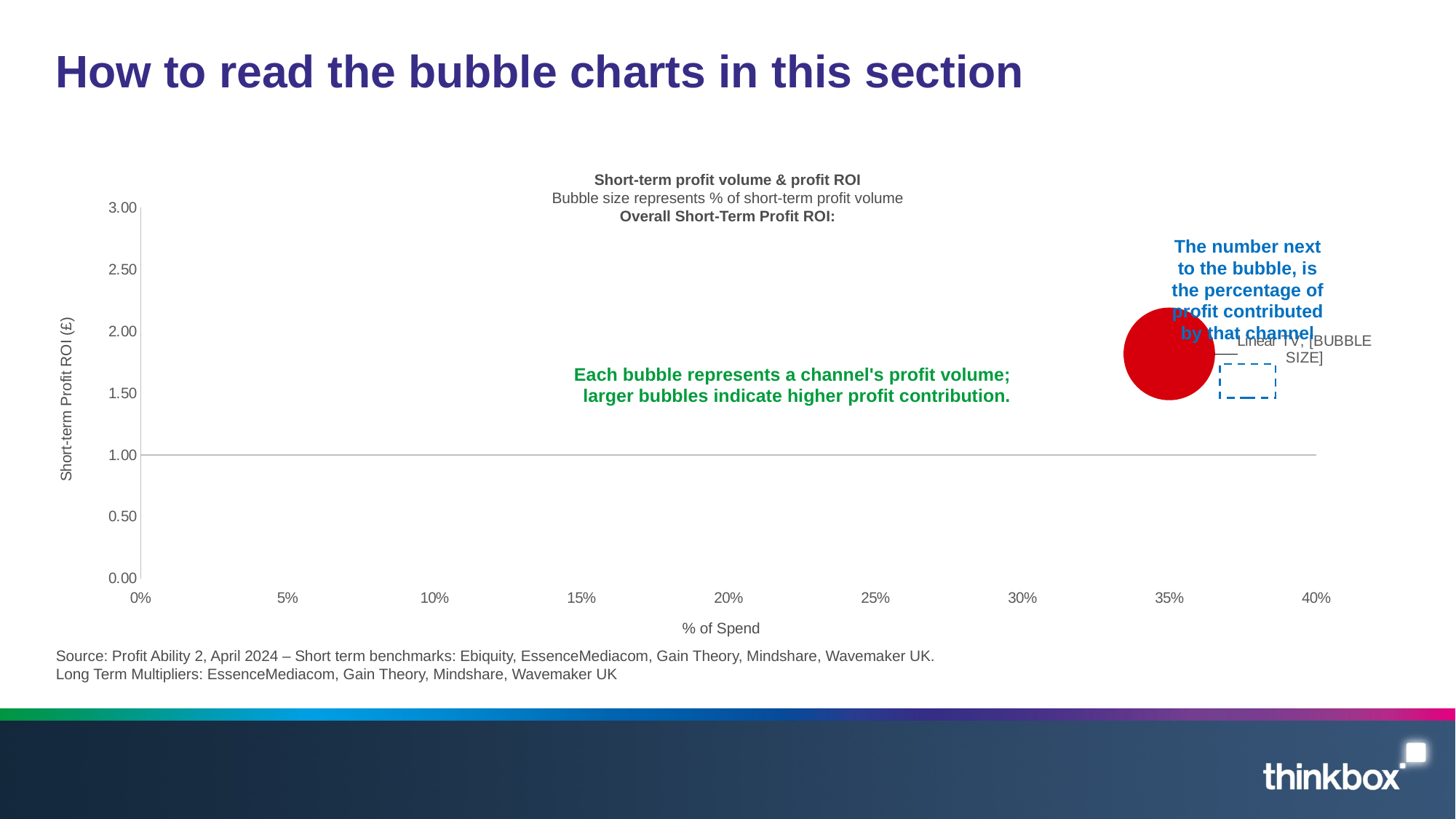
Is the Short-term Profit ROI value for the Linear TV bubble greater or less than 1.00? greater Is the Short-term Profit ROI value for the Linear TV bubble greater or less than 2.50? less What is the title of the y axis on the chart? Short-term Profit ROI (£) How many bubbles are plotted on the chart? 1 What kind of chart is shown on the slide? Bubble chart At which y-axis value is the horizontal reference line drawn across the chart? 1.00 Is the % of Spend value for the Linear TV bubble greater or less than 40%? less What is the maximum value shown on the y axis of the chart? 3.00 What is the title of the x axis on the chart? % of Spend Which channel is labelled next to the bubble on the chart? Linear TV